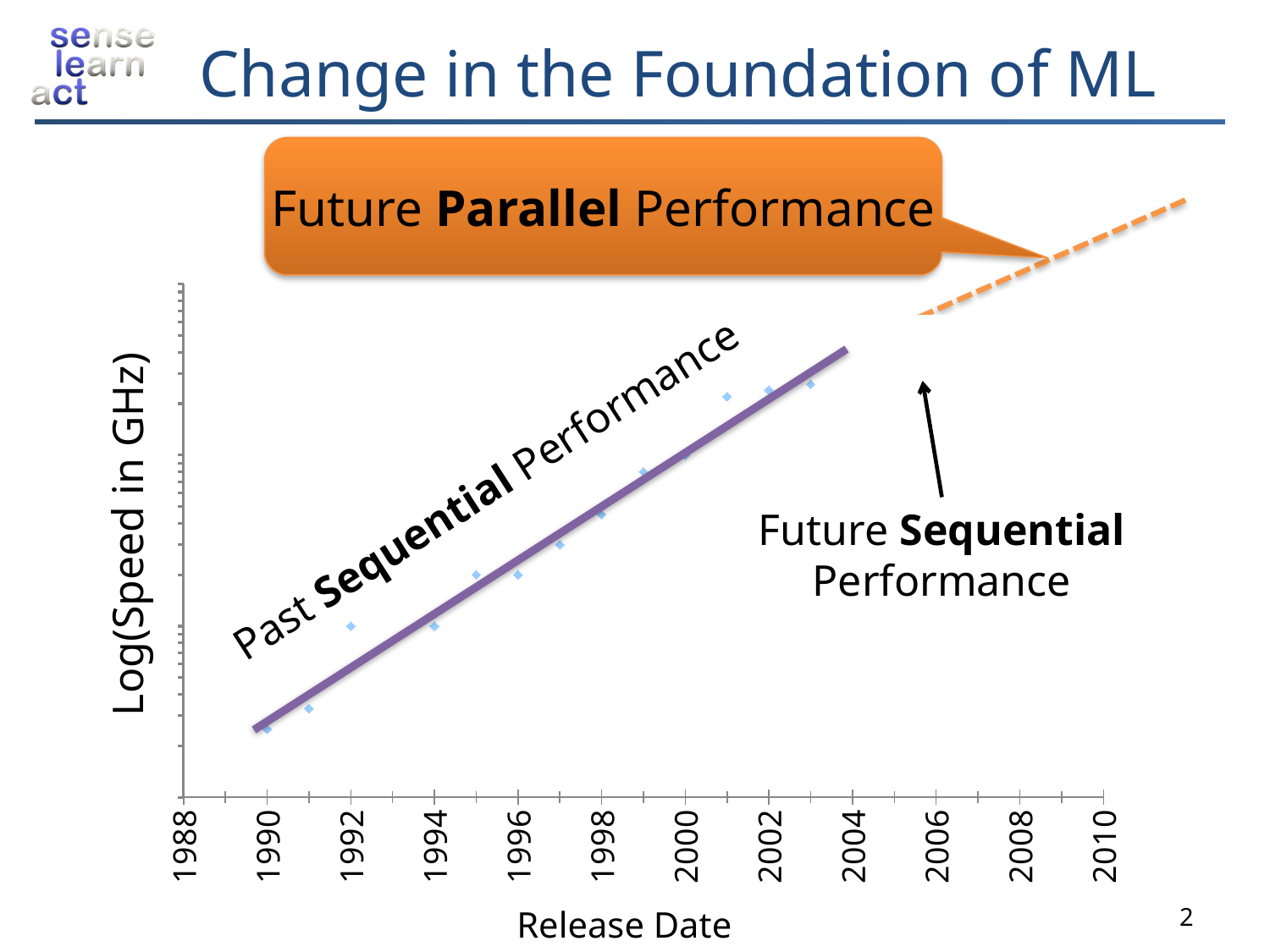
How many year labels are shown on the x axis? 12 What label is written along the solid purple trend line? Past Sequential Performance What is the last year label on the x axis? 2010 Which has the larger plotted value, 1996 or 2000? 2000 Which release date has the lowest plotted value? 1990 What is the first year label on the x axis? 1988 Do the plotted values rise or fall as the release date increases? rise What does the orange callout label the dashed orange line as? Future Parallel Performance Which has the larger plotted value, 1994 or 1998? 1998 Which has the larger plotted value, 1990 or 2003? 2003 What kind of chart is shown on the slide? scatter chart